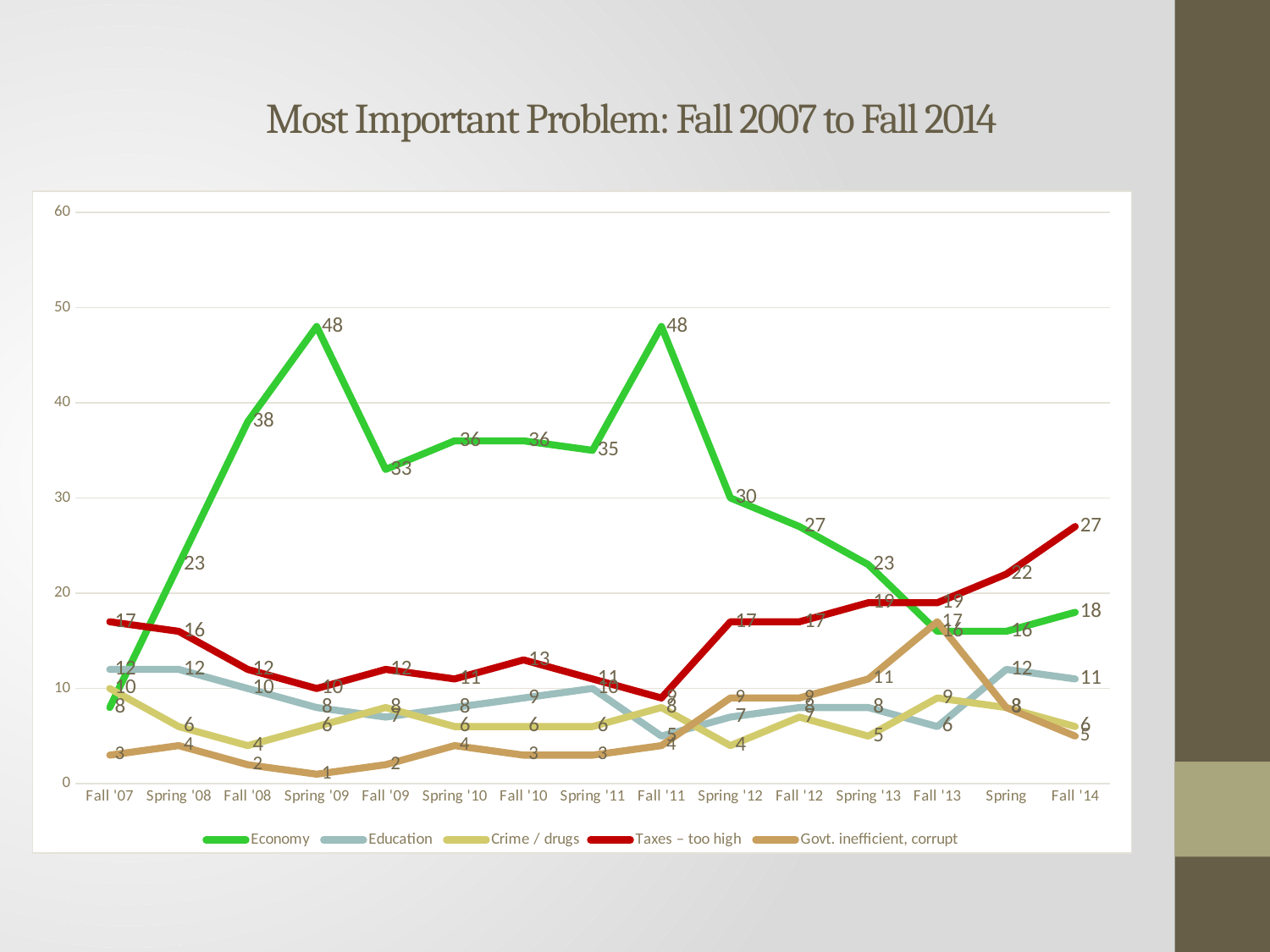
At Fall '14, which is larger: Taxes – too high or Economy? Taxes – too high How many time points are shown on the x axis? 15 What is the difference between the Economy value at Fall '11 and at Spring '12? 18 Is the value for Economy at Spring '09 greater or less than 40? greater How many series does the legend list? 5 What is the value for Govt. inefficient, corrupt at Fall '13? 17 What is the value for Taxes – too high at Fall '14? 27 At which point does Govt. inefficient, corrupt reach its lowest value? Spring '09 What is the value for Economy at Spring '09? 48 What is the highest value reached by the Economy line? 48 What is the value for Economy at Fall '08? 38 What kind of chart is shown on the slide? line chart